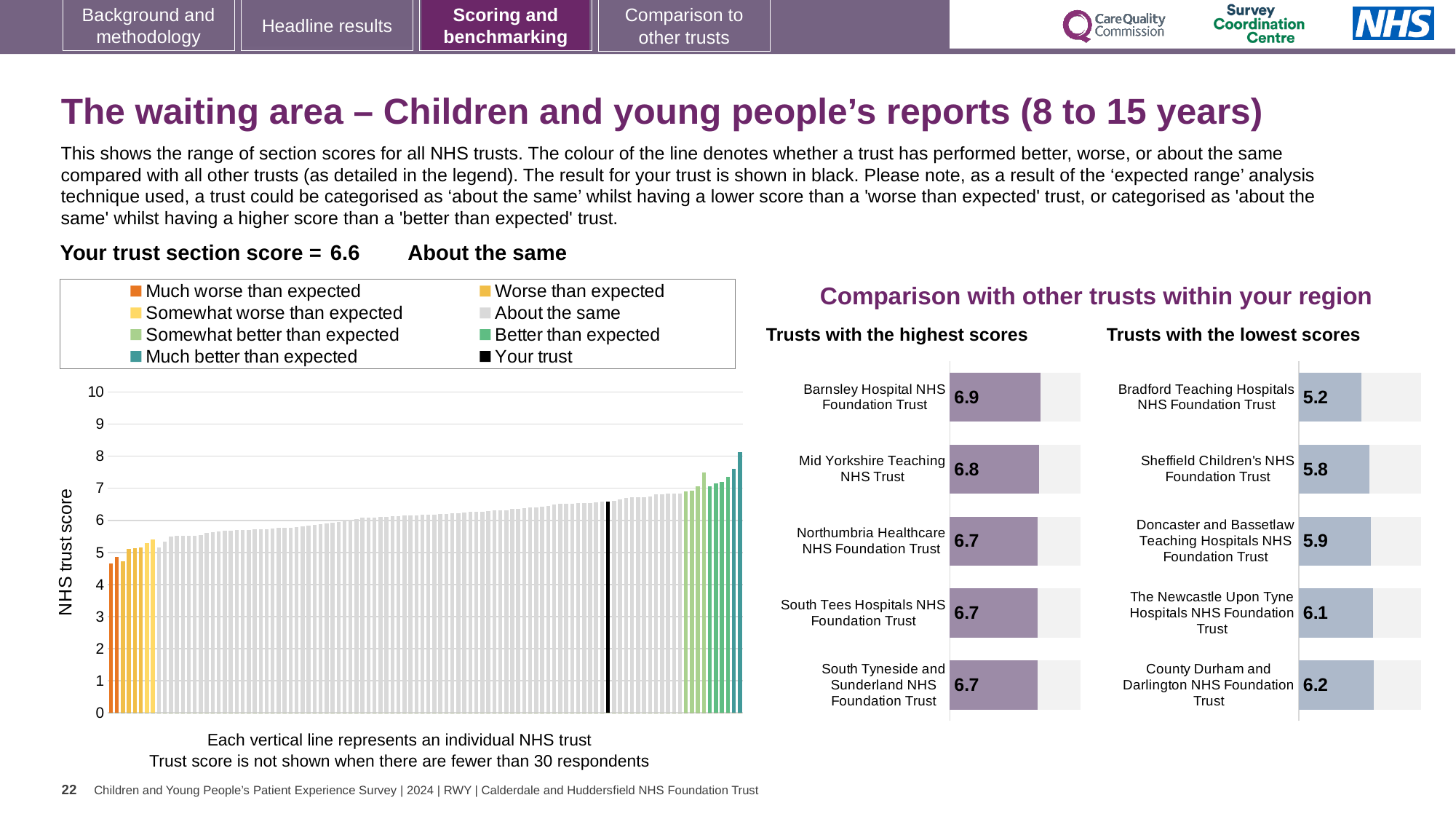
In the 'Trusts with the highest scores' chart, what is the score for Barnsley Hospital NHS Foundation Trust? 6.9 In the 'Trusts with the lowest scores' chart, what is the difference between the scores of County Durham and Darlington NHS Foundation Trust and Bradford Teaching Hospitals NHS Foundation Trust? 1.0 In the 'Trusts with the highest scores' chart, which trust has the highest score? Barnsley Hospital NHS Foundation Trust In the 'Trusts with the highest scores' chart, what is the difference between the scores of Barnsley Hospital NHS Foundation Trust and Mid Yorkshire Teaching NHS Trust? 0.1 In the large chart on the left, is the value of the lowest (leftmost) bar greater or less than 5? less In the 'Trusts with the lowest scores' chart, which has the larger score: Sheffield Children's NHS Foundation Trust or Doncaster and Bassetlaw Teaching Hospitals NHS Foundation Trust? Doncaster and Bassetlaw Teaching Hospitals NHS Foundation Trust In the large chart on the left, do the bar values rise or fall from left to right? rise In the large chart on the left, what is the section score for 'Your trust' (the black bar)? 6.6 What kind of chart is the large chart on the left with the y axis labelled 'NHS trust score'? bar chart How many entries does the legend above the large chart on the left list? 8 How many trusts are shown in the 'Trusts with the lowest scores' chart? 5 In the 'Trusts with the lowest scores' chart, which trust has the lowest score? Bradford Teaching Hospitals NHS Foundation Trust